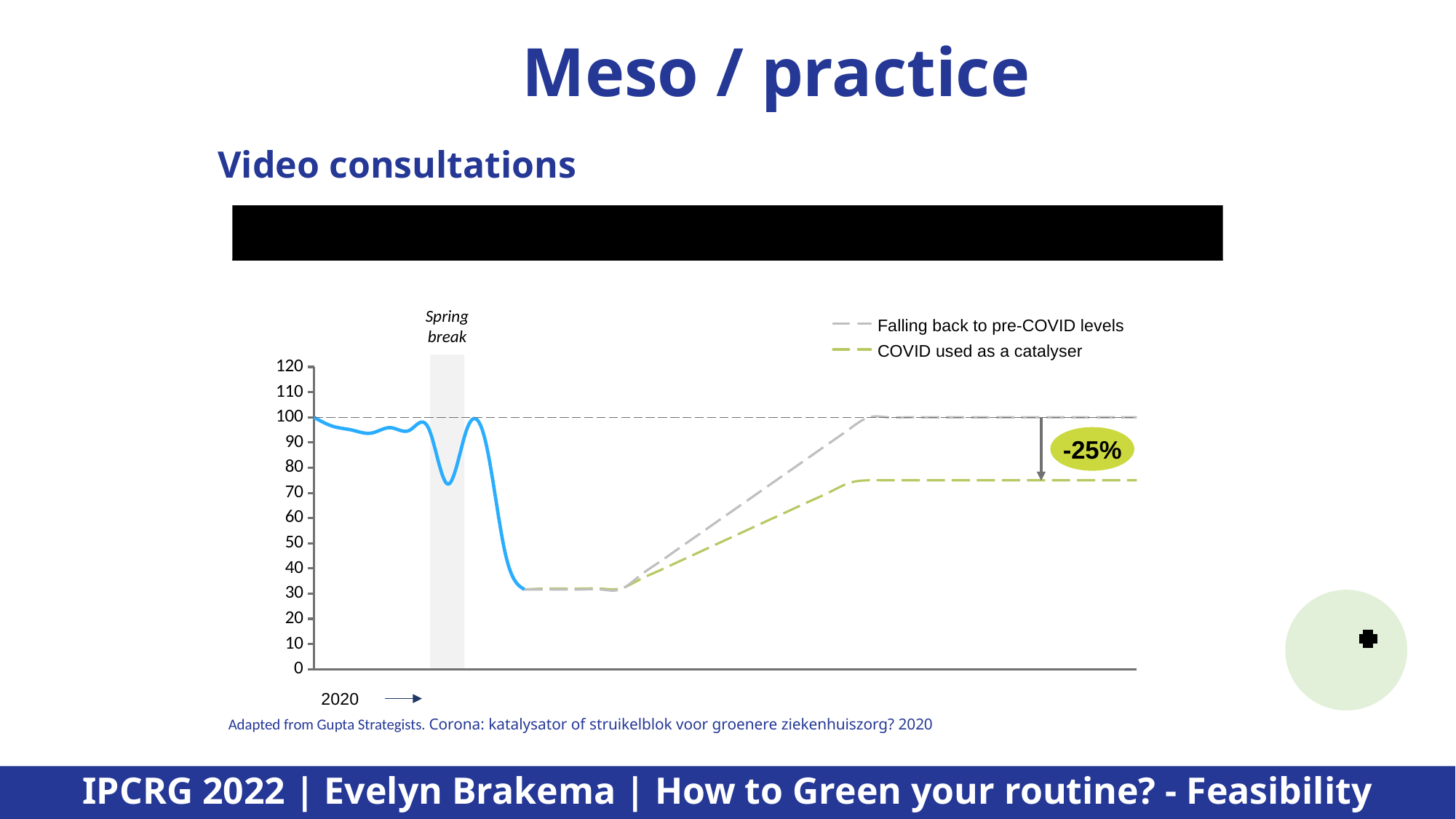
What year is shown on the x axis of the chart? 2020 What is the label of the shaded vertical band on the chart? Spring break Is the final value of the 'COVID used as a catalyser' line greater or less than 80? less Which series ends at a higher level on the right side of the chart, 'Falling back to pre-COVID levels' or 'COVID used as a catalyser'? Falling back to pre-COVID levels How many series does the legend list? 2 What percentage is shown in the yellow-green oval annotation on the chart? -25% What kind of chart is shown on the slide? line chart Does the blue line rise or fall from its starting value to its plateau after the spring break? fall At what level does the 'Falling back to pre-COVID levels' line end at the right side of the chart? 100 Is the final value of the 'COVID used as a catalyser' line greater or less than 70? greater Is the value of the blue line at its low plateau (after the spring break) greater or less than 40? less What is the legend label for the grey dashed line? Falling back to pre-COVID levels